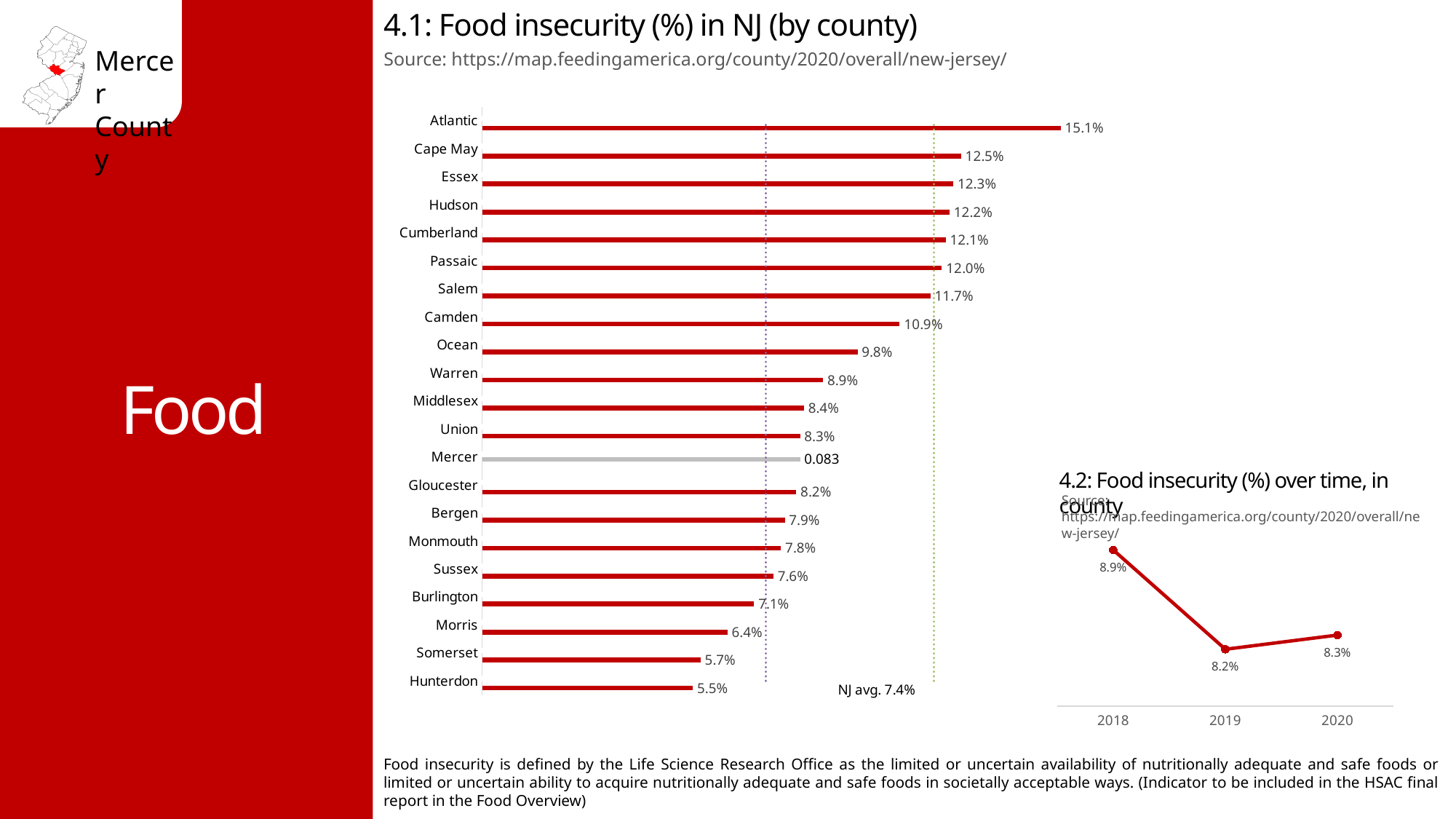
What kind of chart is chart 4.1 (Food insecurity (%) in NJ by county)? Bar chart In chart 4.2 (Food insecurity (%) over time, in county), what is the difference between the 2018 and 2019 values? 0.7% In chart 4.1 (Food insecurity (%) in NJ by county), what is the value for Camden? 10.9% In chart 4.1 (Food insecurity (%) in NJ by county), what is the difference between Atlantic and Hunterdon? 9.6% In chart 4.1 (Food insecurity (%) in NJ by county), which county has the lowest food insecurity? Hunterdon In chart 4.1 (Food insecurity (%) in NJ by county), what is the value for Atlantic? 15.1% In chart 4.2 (Food insecurity (%) over time, in county), which year has the highest value? 2018 In chart 4.2 (Food insecurity (%) over time, in county), what is the value for 2019? 8.2% In chart 4.1 (Food insecurity (%) in NJ by county), which county has the highest food insecurity? Atlantic In chart 4.1 (Food insecurity (%) in NJ by county), how many counties are plotted? 21 In chart 4.1 (Food insecurity (%) in NJ by county), which is larger, the value for Ocean or the value for Warren? Ocean In chart 4.1 (Food insecurity (%) in NJ by county), what NJ average is labelled on the chart? 7.4%